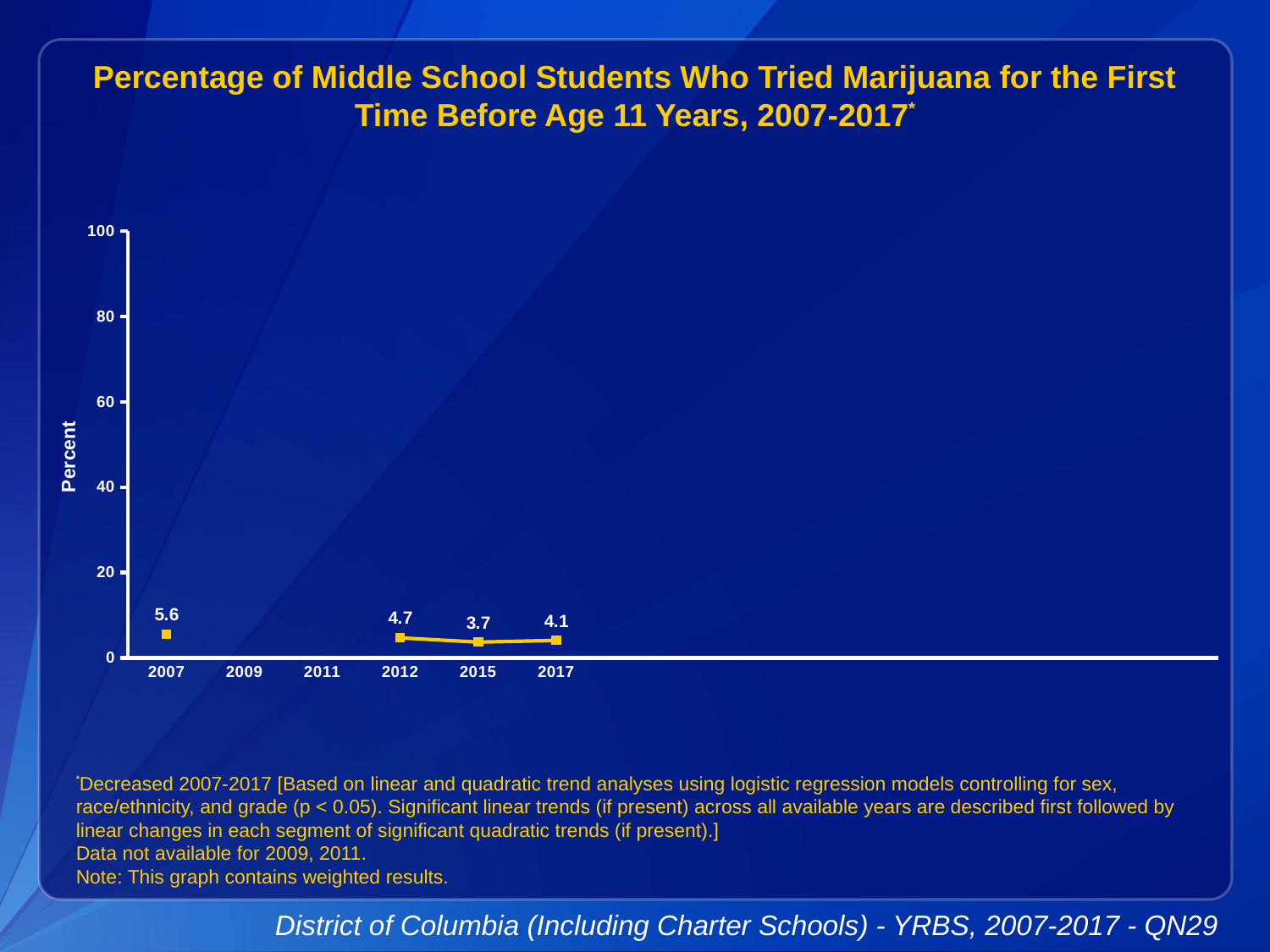
Is the value for 2007 greater or less than 20? less Which year has the lowest value? 2015 What is the difference between the values for 2007 and 2017? 1.5 What is the value for 2017? 4.1 What kind of chart is shown? line chart What is the value for 2012? 4.7 What is the label on the y axis? Percent How many years have data points plotted on the chart? 4 What is the value for 2007? 5.6 Which is larger, the value for 2012 or the value for 2015? 2012 What is the value for 2015? 3.7 Which year has the highest value? 2007